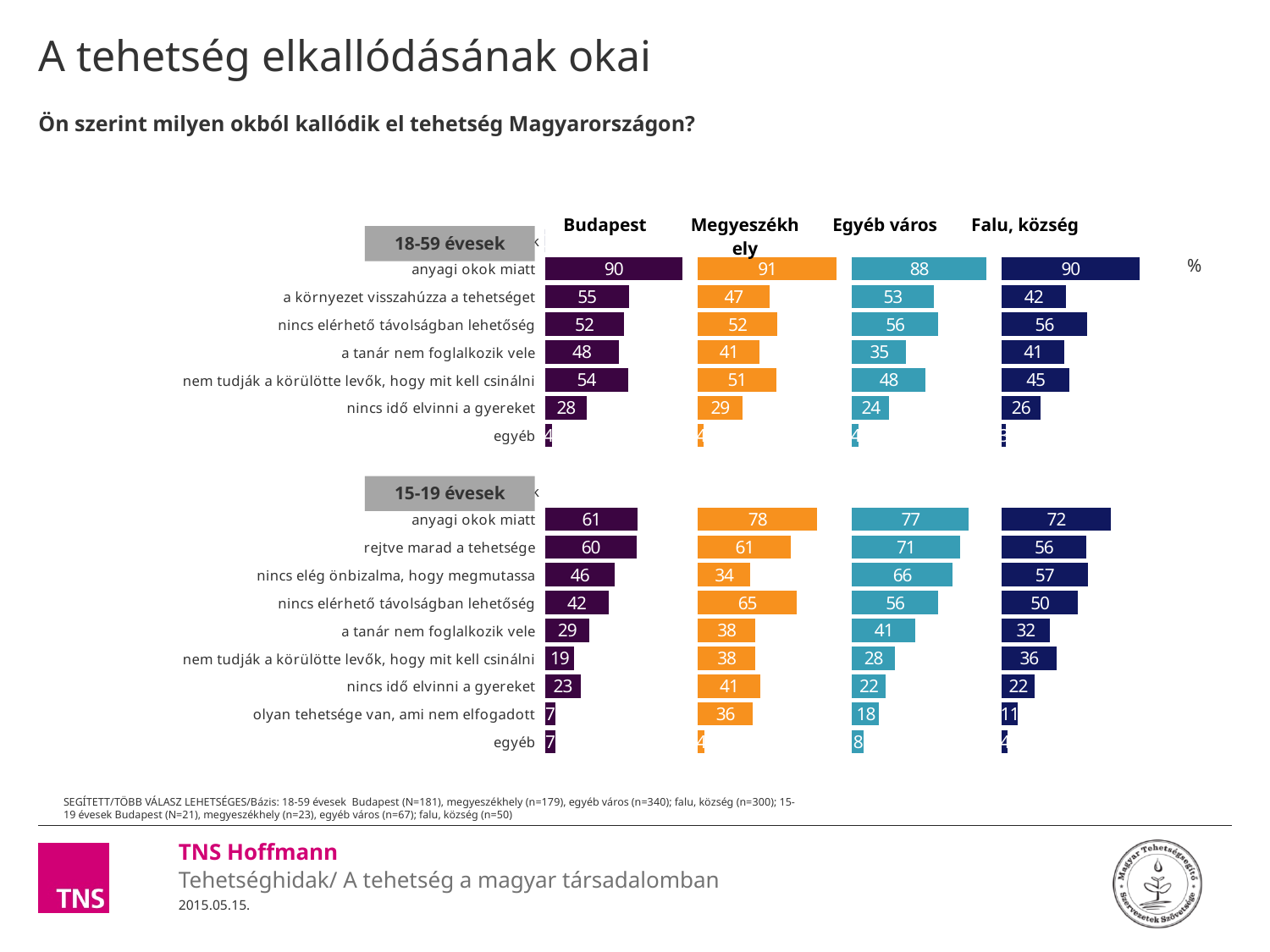
In the 15-19 évesek chart, what is the difference between the Megyeszékhely and Budapest values for 'nincs elérhető távolságban lehetőség'? 23 What colour are the bars in the Megyeszékhely column? Orange In the 18-59 évesek chart, which is larger for 'a tanár nem foglalkozik vele': the Budapest value or the Egyéb város value? Budapest In the 15-19 évesek chart, which location has the highest value for 'anyagi okok miatt'? Megyeszékhely In the 18-59 évesek chart, what is the Budapest value for 'anyagi okok miatt'? 90 In the 15-19 évesek chart, what is the Megyeszékhely value for 'olyan tehetsége van, ami nem elfogadott'? 36 What type of chart is used on this slide? Bar chart In the 18-59 évesek chart, what is the Egyéb város value for 'nincs elérhető távolságban lehetőség'? 56 How many reason categories are listed in the 15-19 évesek chart? 9 In the 15-19 évesek chart, what is the Falu, község value for 'nincs elég önbizalma, hogy megmutassa'? 57 In the 15-19 évesek chart, which location has the lowest value for 'nem tudják a körülötte levők, hogy mit kell csinálni'? Budapest In the 18-59 évesek chart, what is the difference between the Budapest and Falu, község values for 'a környezet visszahúzza a tehetséget'? 13